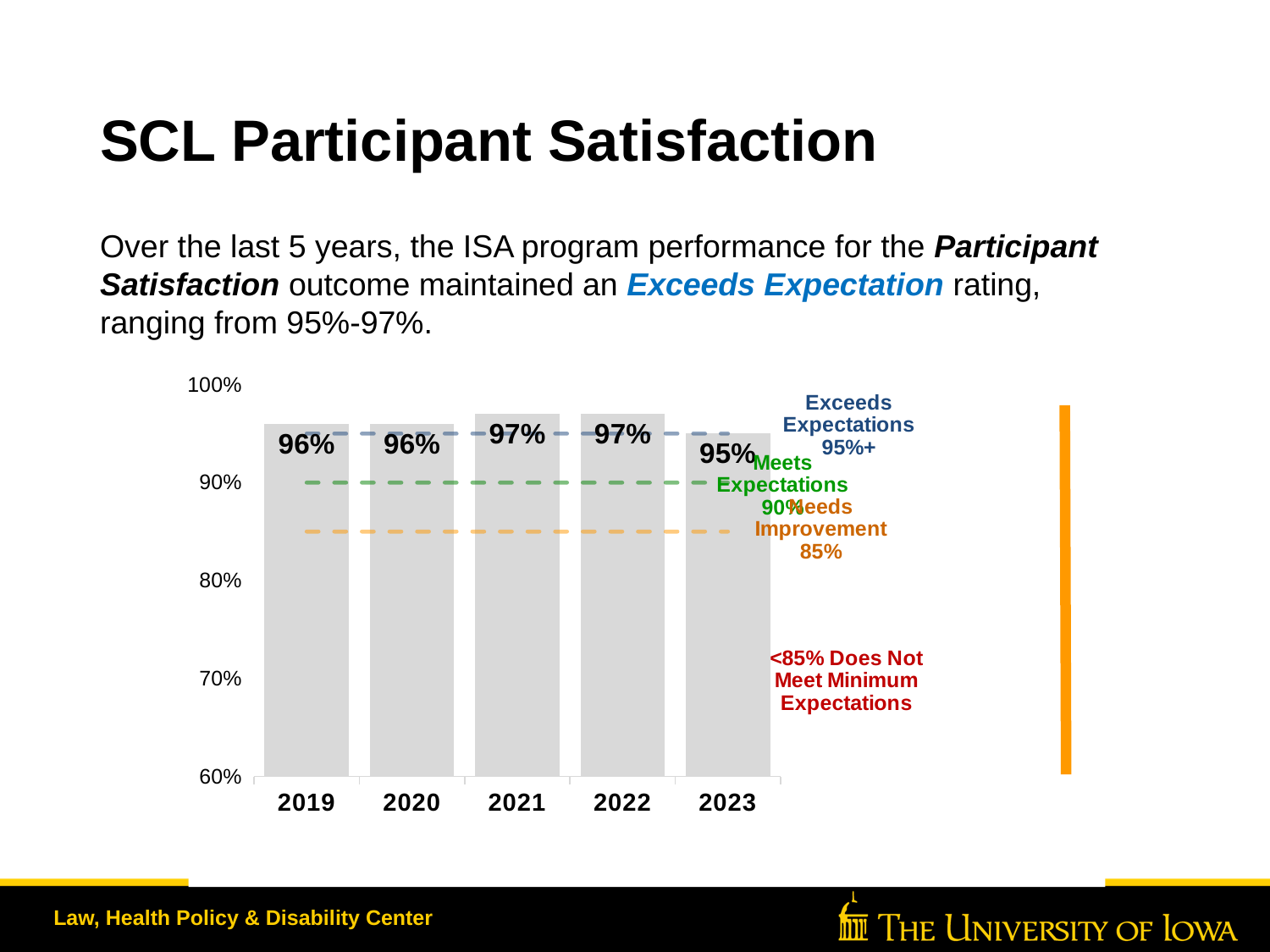
Which year has the lowest participant satisfaction value? 2023 What is the participant satisfaction value for 2023? 95% What threshold is labelled as 'Exceeds Expectations' on the chart? 95%+ Do the values rise or fall from 2022 to 2023? fall Is the value for 2023 greater or less than 90%? greater What threshold is labelled as 'Needs Improvement' on the chart? 85% What is the participant satisfaction value for 2021? 97% What is the difference between the 2022 value and the 2023 value? 2% What is the participant satisfaction value for 2019? 96% How many years are shown on the x axis of the chart? 5 Which is larger, the value for 2020 or the value for 2021? 2021 What kind of chart is shown on the slide? bar chart